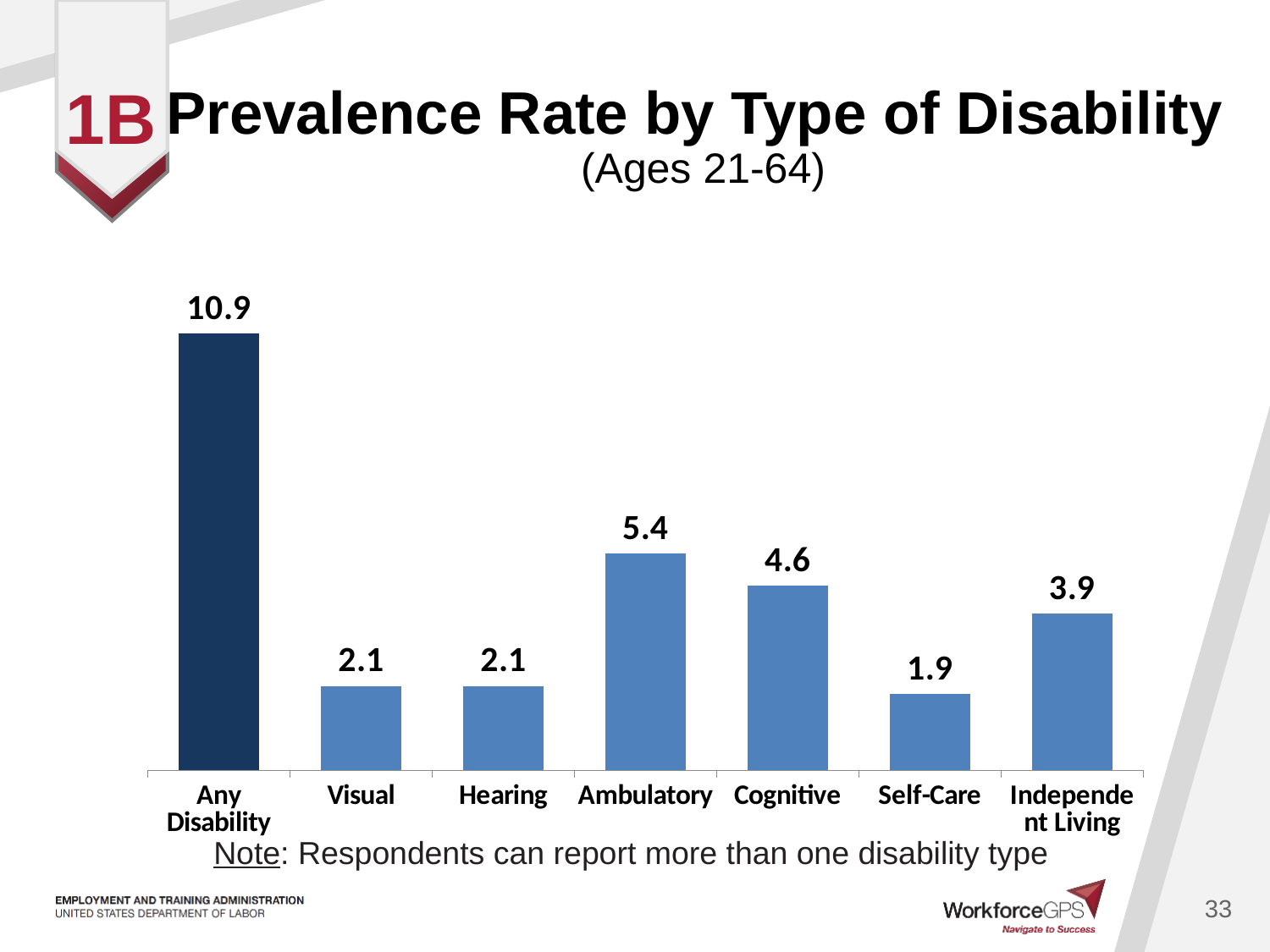
What kind of chart is shown on the slide? Bar chart What is the difference between the prevalence rates for Ambulatory and Cognitive disabilities? 0.8 What is the prevalence rate for Independent Living disability? 3.9 Which category has the highest prevalence rate? Any Disability What is the prevalence rate for Any Disability? 10.9 Which category has the lowest prevalence rate? Self-Care What is the prevalence rate for Ambulatory disability? 5.4 What is the difference between the prevalence rates for Any Disability and Ambulatory? 5.5 What age range does the chart title specify? Ages 21-64 How many disability categories are shown in the chart? 7 Which has a higher prevalence rate, Self-Care or Visual? Visual Which has a higher prevalence rate, Cognitive or Independent Living? Cognitive